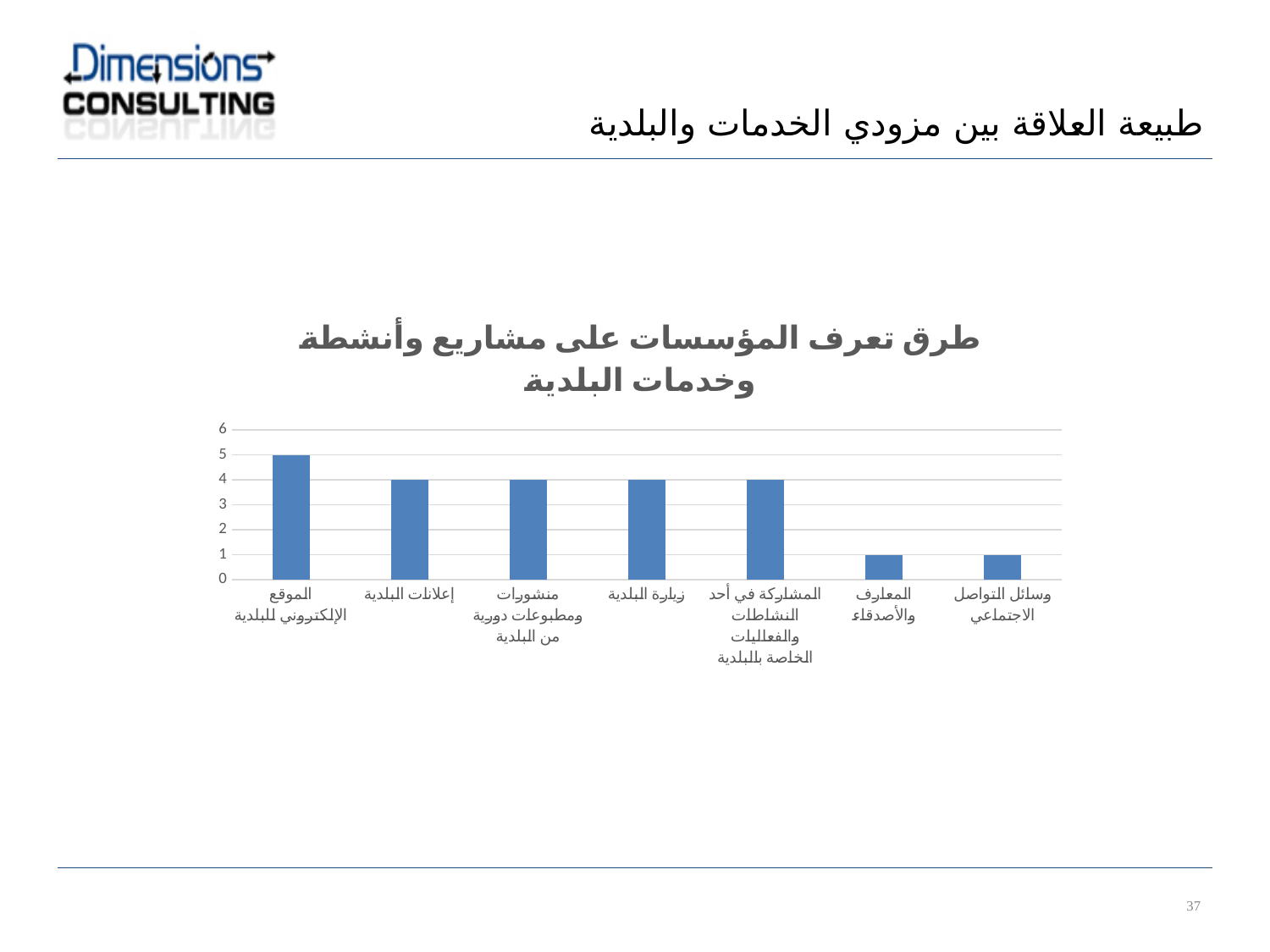
What type of chart is shown on the slide? Bar chart Is the value for المعارف والأصدقاء greater or less than 3? less What is the difference between the values for الموقع الإلكتروني للبلدية and المعارف والأصدقاء? 4 What is the value for الموقع الإلكتروني للبلدية? 5 Which category has the highest value? الموقع الإلكتروني للبلدية What is the value for وسائل التواصل الاجتماعي? 1 Do the values generally rise or fall moving from left to right along the x axis? fall What is the title of the chart? طرق تعرف المؤسسات على مشاريع وأنشطة وخدمات البلدية What is the value for زيارة البلدية? 4 What is the value for إعلانات البلدية? 4 Which is larger, the value for الموقع الإلكتروني للبلدية or the value for إعلانات البلدية? الموقع الإلكتروني للبلدية How many categories are shown on the x axis of the chart? 7